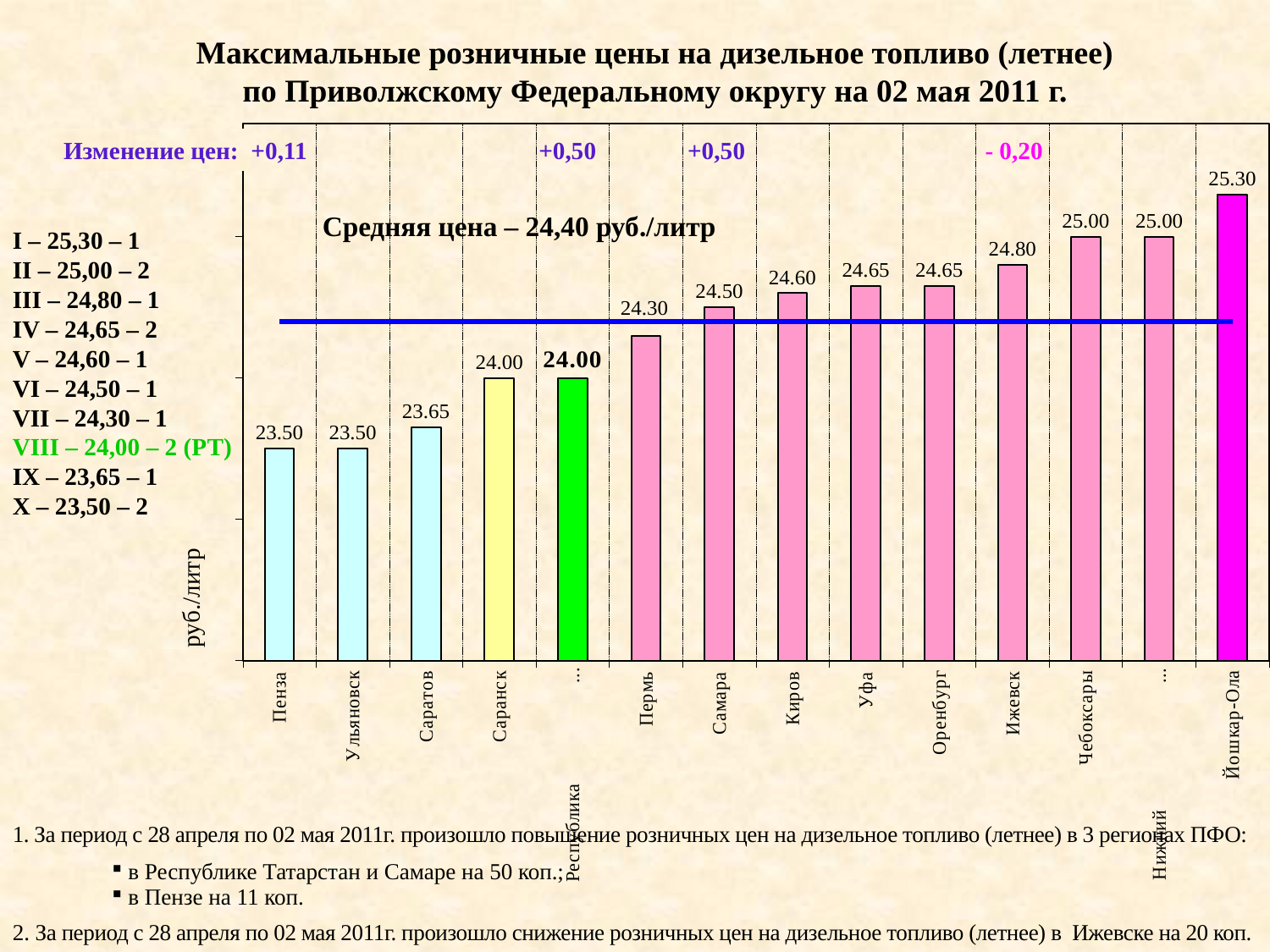
What average price (Средняя цена) is stated on the chart? 24,40 руб./литр What value is shown for Пермь? 24.30 What value is shown for Саратов? 23.65 How many bars (cities) are plotted on the chart? 14 What value is shown for Ижевск? 24.80 Which city has the highest bar on the chart? Йошкар-Ола What is the maximum retail price of diesel fuel shown for Йошкар-Ола? 25.30 What kind of chart is shown on the slide? bar chart Which is larger, the value for Уфа or the value for Пермь? Уфа What is the difference between the values for Йошкар-Ола and Пенза? 1.80 Which is larger, the value for Саранск or the value for Саратов? Саранск What is the difference between the values for Киров and Самара? 0.10